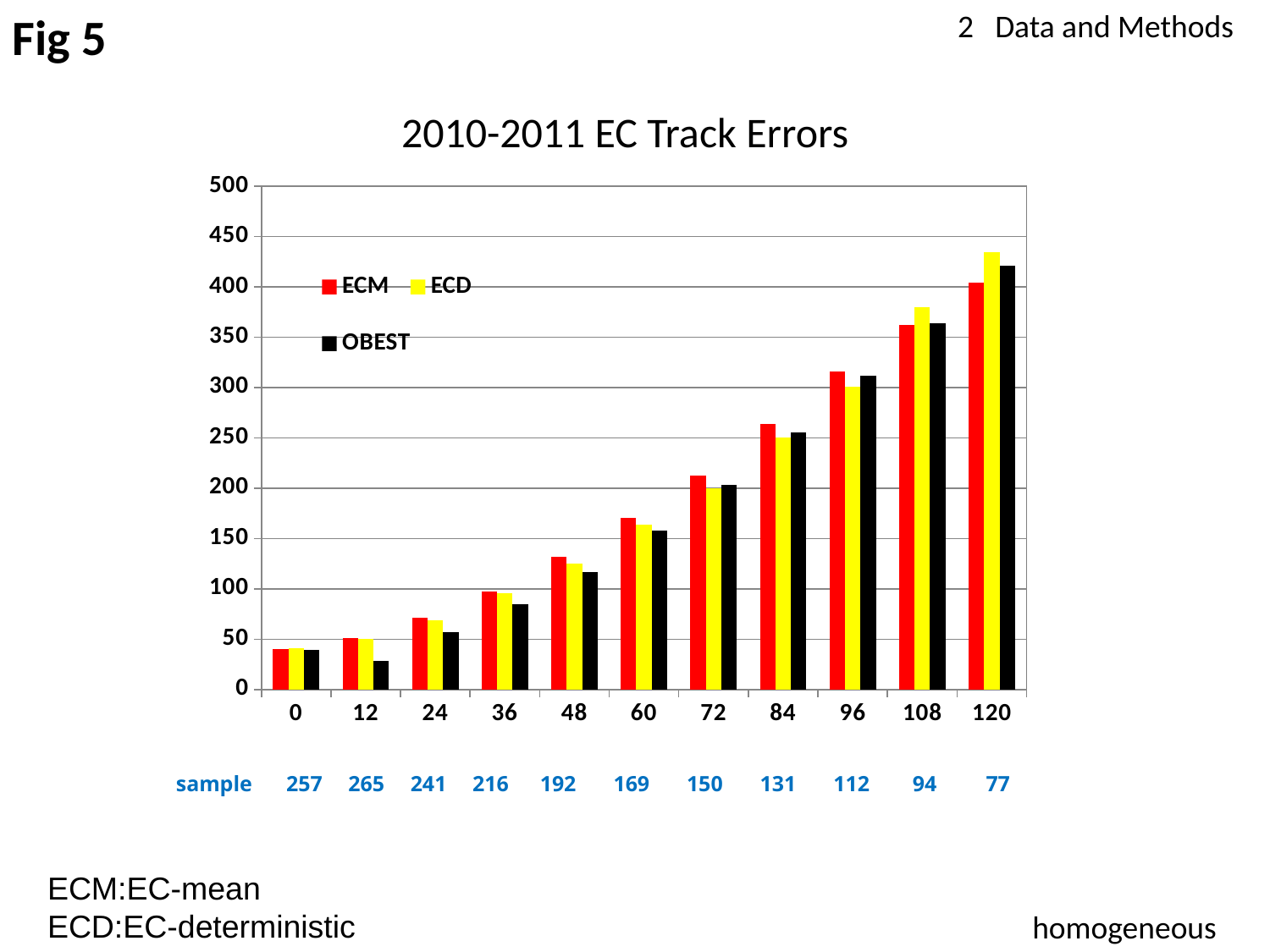
Is the ECM value at x = 84 greater or less than 250? greater Is the OBEST value at x = 36 greater or less than 100? less Which series has the tallest bar at x = 120? ECD What type of chart is shown on the slide? bar chart How many categories are shown along the x axis? 11 Do the track error values rise or fall as the x-axis value increases from 0 to 120? rise Is the ECD value at x = 120 greater or less than 400? greater How many series does the legend list? 3 What is the title of the chart? 2010-2011 EC Track Errors Which series has the shortest bar at x = 12? OBEST At x = 48, which is larger, the ECM bar or the OBEST bar? ECM